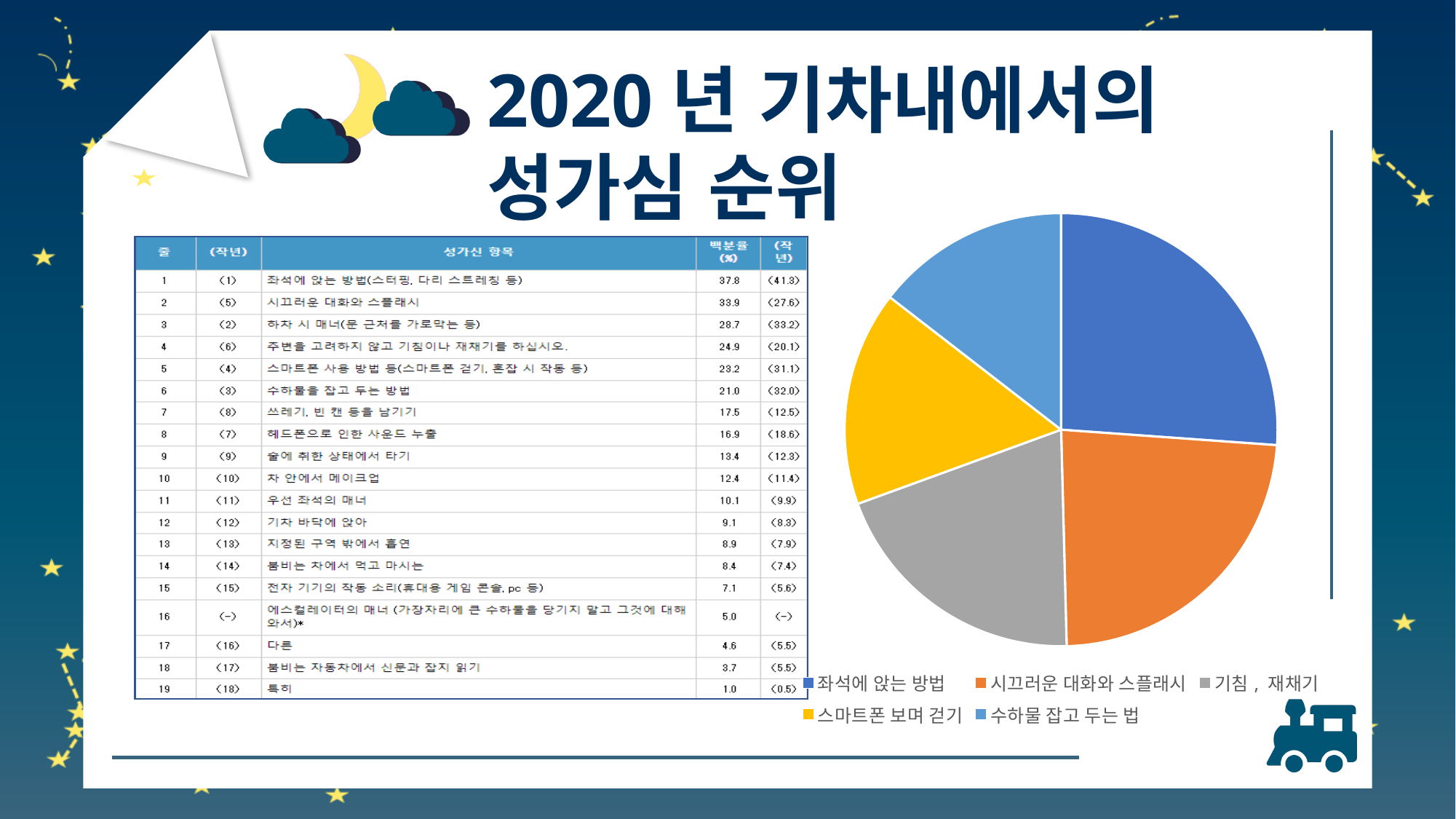
In the pie chart, which slice is larger: 좌석에 앉는 방법 or 수하물 잡고 두는 법? 좌석에 앉는 방법 What kind of chart is shown on the right side of the slide? Pie chart Which legend category is shown in yellow in the pie chart? 스마트폰 보며 걷기 What colour is the 기침, 재채기 slice in the pie chart? Gray Which category has the largest slice in the pie chart? 좌석에 앉는 방법 How many entries does the pie chart's legend list? 5 In the pie chart, which slice is larger: 시끄러운 대화와 스플래시 or 수하물 잡고 두는 법? 시끄러운 대화와 스플래시 How many slices does the pie chart have? 5 In the pie chart, which slice is larger: 좌석에 앉는 방법 or 기침, 재채기? 좌석에 앉는 방법